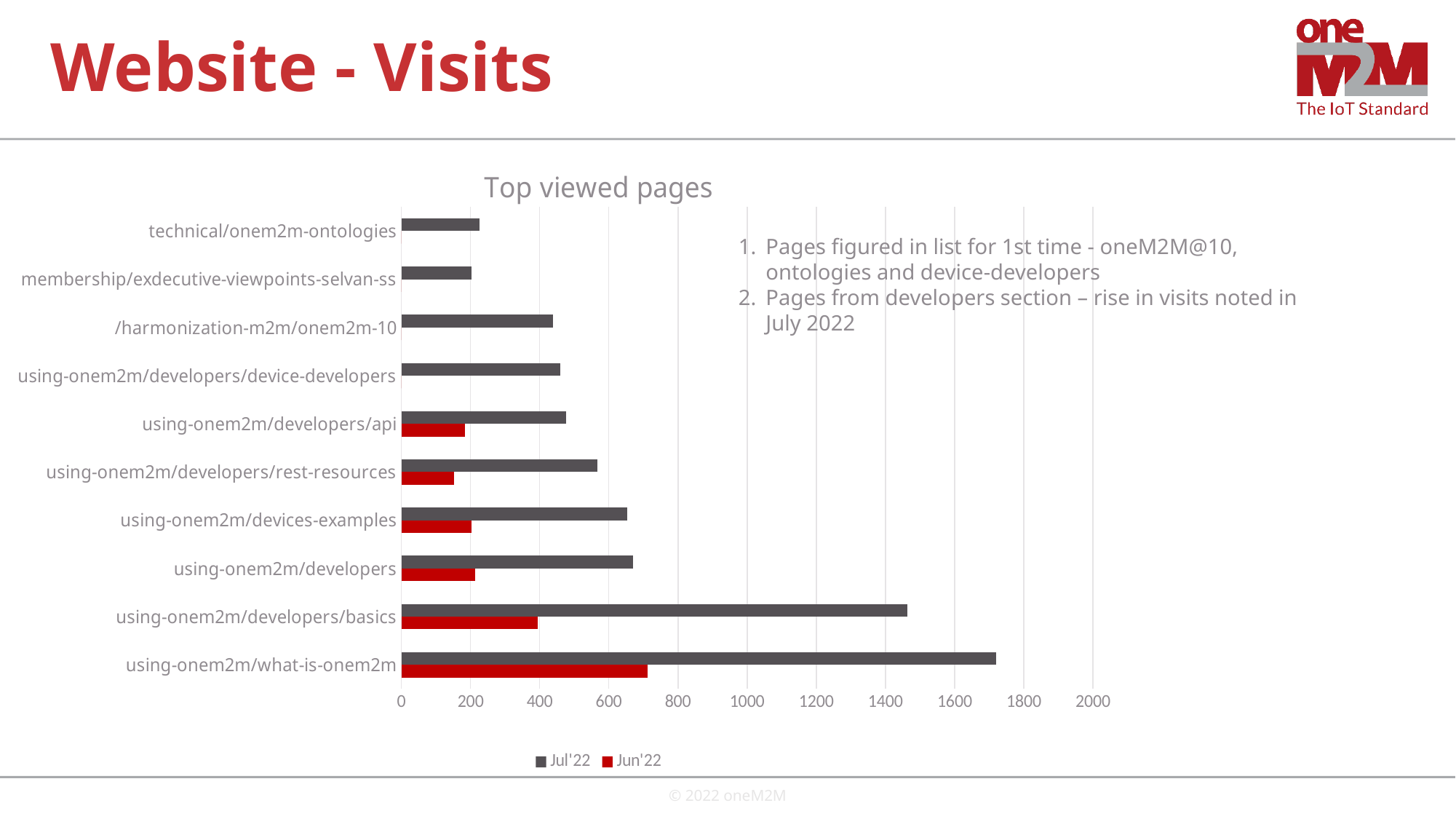
Which page has the highest Jun'22 value? using-onem2m/what-is-onem2m What kind of chart is shown on the slide? bar chart Is the Jul'22 value for using-onem2m/developers/basics greater or less than 1400? greater How many series does the chart's legend list? 2 Which series is shown in red in the chart? Jun'22 Which page has the highest Jul'22 value? using-onem2m/what-is-onem2m Is the Jul'22 value for using-onem2m/what-is-onem2m greater or less than 1600? greater What is the title of the chart? Top viewed pages Is the Jun'22 value for using-onem2m/what-is-onem2m greater or less than 600? greater Which is larger: the Jul'22 value for using-onem2m/developers/basics or the Jul'22 value for using-onem2m/developers? using-onem2m/developers/basics How many pages (categories) are plotted in the chart? 10